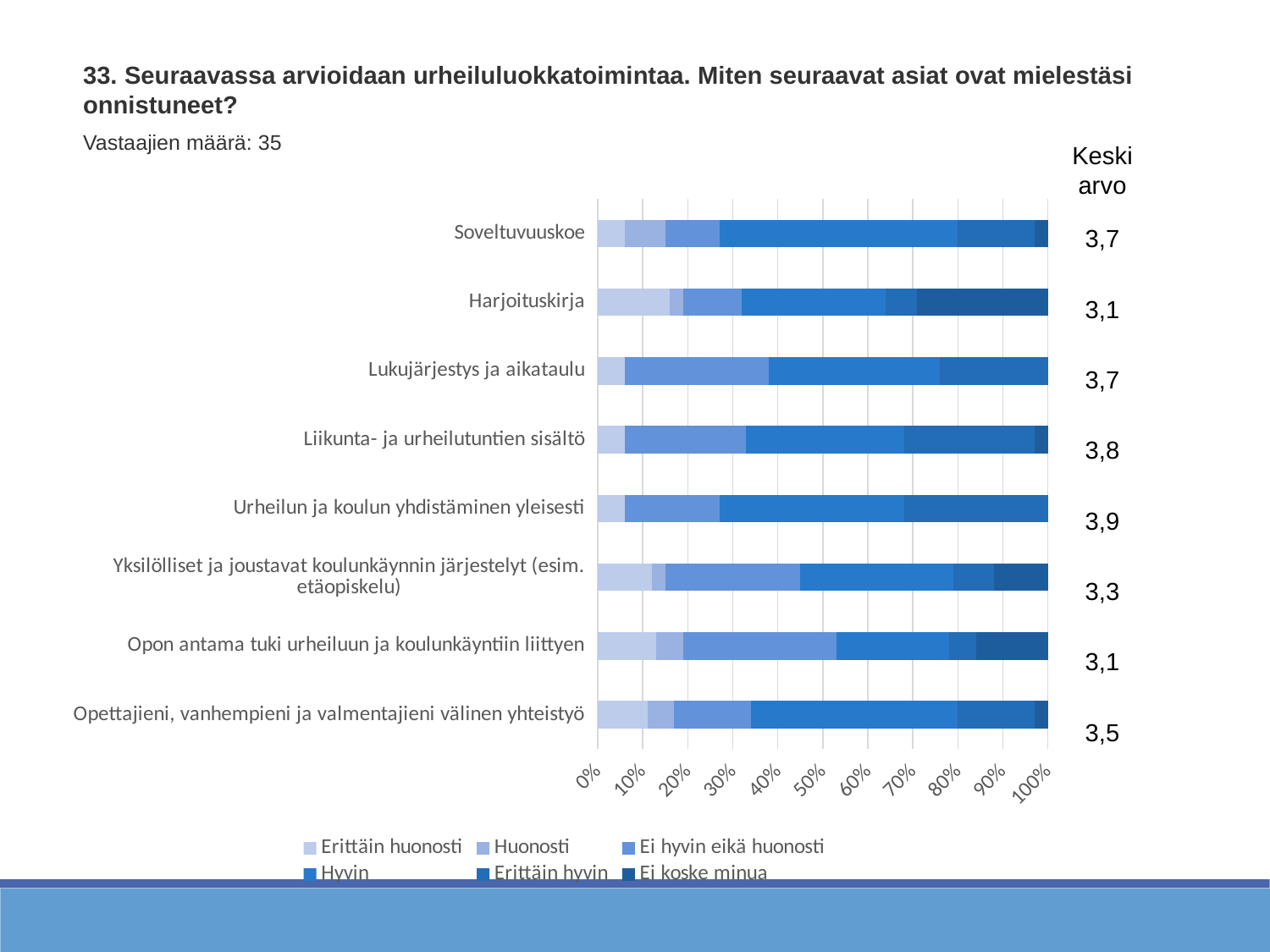
Which has the larger Keskiarvo value: 'Soveltuvuuskoe' or 'Yksilölliset ja joustavat koulunkäynnin järjestelyt (esim. etäopiskelu)'? Soveltuvuuskoe What kind of chart is shown on the slide? Stacked bar chart What is the Keskiarvo value shown for 'Harjoituskirja'? 3,1 How many categories (rows) does the chart show? 8 What is the difference between the Keskiarvo values of 'Urheilun ja koulun yhdistäminen yleisesti' and 'Harjoituskirja'? 0,8 What is the Keskiarvo value shown for 'Liikunta- ja urheilutuntien sisältö'? 3,8 What is the first entry in the chart's legend? Erittäin huonosti Is the 'Ei koske minua' share for 'Harjoituskirja' greater or less than 20%? greater How many series does the legend list? 6 Is the 'Erittäin huonosti' share for 'Lukujärjestys ja aikataulu' greater or less than 10%? less Which category has the highest Keskiarvo value? Urheilun ja koulun yhdistäminen yleisesti What is the Keskiarvo value shown for 'Urheilun ja koulun yhdistäminen yleisesti'? 3,9